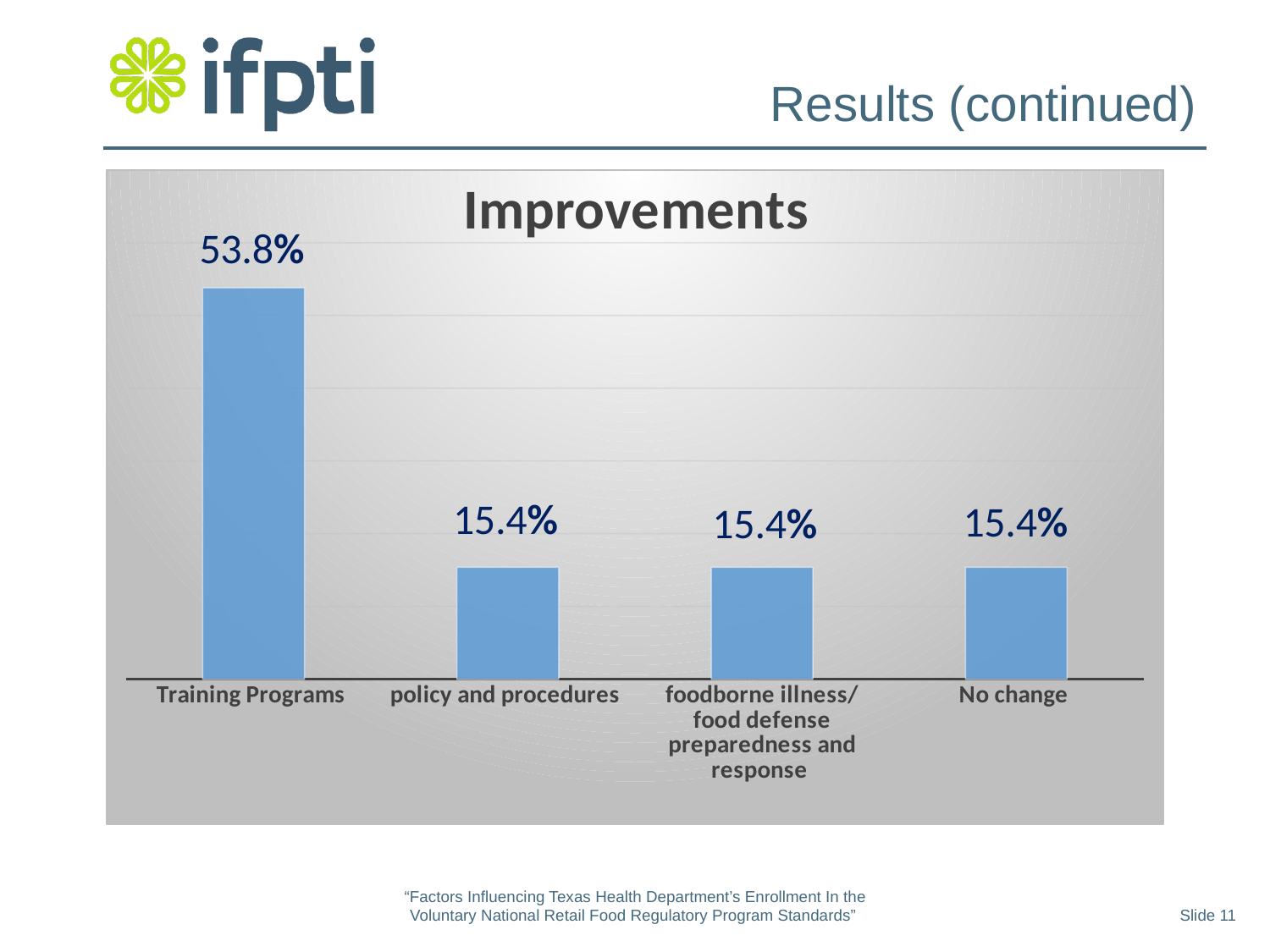
What is the value for No change? 15.4% What is the value for policy and procedures? 15.4% Which category has the highest value? Training Programs Which is larger, the value for Training Programs or the value for policy and procedures? Training Programs What is the value for foodborne illness/ food defense preparedness and response? 15.4% What colour are the bars in the chart? Blue What is the difference between the values for Training Programs and No change? 38.4% What is the title of the chart? Improvements How many categories share the value 15.4%? 3 What kind of chart is shown on the slide? Bar chart How many categories are shown in the chart? 4 What is the value for Training Programs? 53.8%